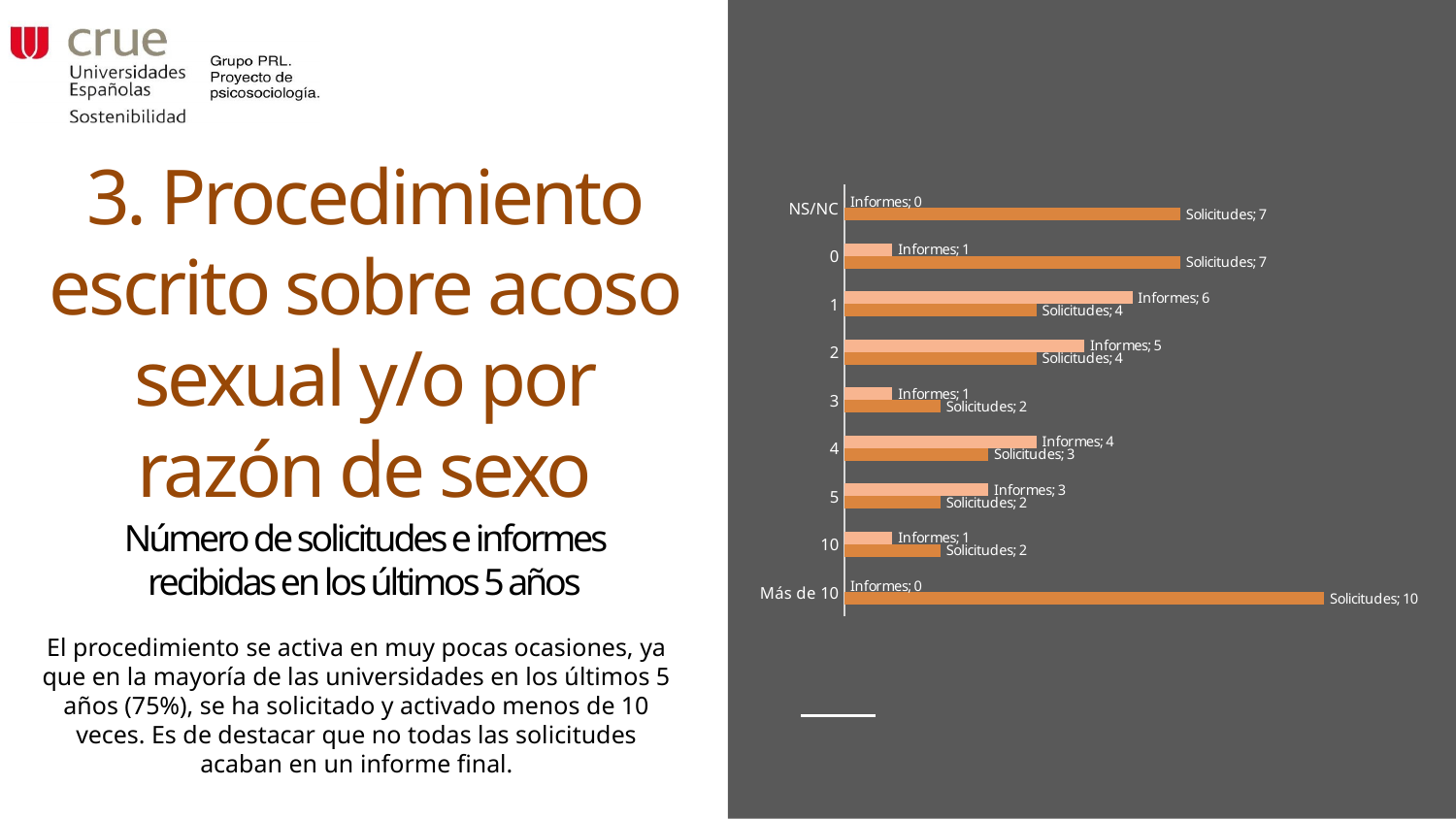
For the category '2', which is larger: Informes or Solicitudes? Informes What is the difference between Solicitudes and Informes for the category '0'? 6 What type of chart is shown on the slide? bar chart How many categories are shown on the vertical axis of the chart? 9 Which category has the highest value of Solicitudes? Más de 10 What is the value of Informes for the category '1'? 6 What is the subtitle describing the chart's data on the slide? Número de solicitudes e informes recibidas en los últimos 5 años What is the value of Solicitudes for the category 'NS/NC'? 7 What is the value of Solicitudes for the category 'Más de 10'? 10 What is the difference between Solicitudes and Informes for the category 'Más de 10'? 10 Which category has the highest value of Informes? 1 What is the value of Informes for the category '4'? 4